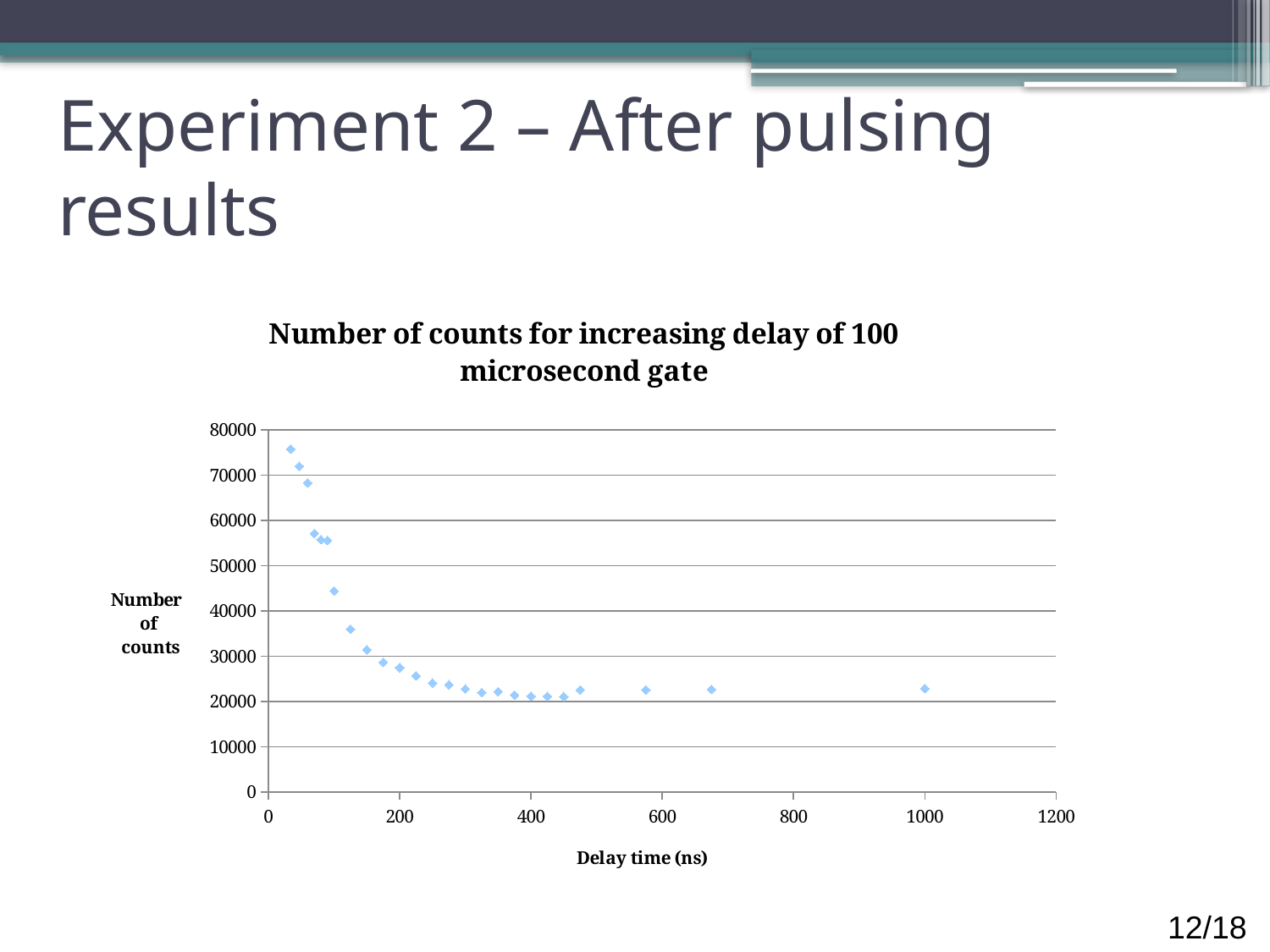
Is the number of counts at a delay time of 1000 ns greater or less than 20000? greater Do the number of counts rise or fall as delay time increases along the x axis? fall What kind of chart is shown on the slide? scatter chart Is the number of counts at a delay time of 200 ns greater or less than 40000? less Is the number of counts at a delay time of 1000 ns greater or less than 30000? less What is the title of the chart? Number of counts for increasing delay of 100 microsecond gate What is the label of the x axis of the chart? Delay time (ns) Does the point with the highest number of counts occur at the smallest or the largest delay time? smallest Which has more counts: the point at a delay time of 100 ns or the point at a delay time of 400 ns? 100 ns